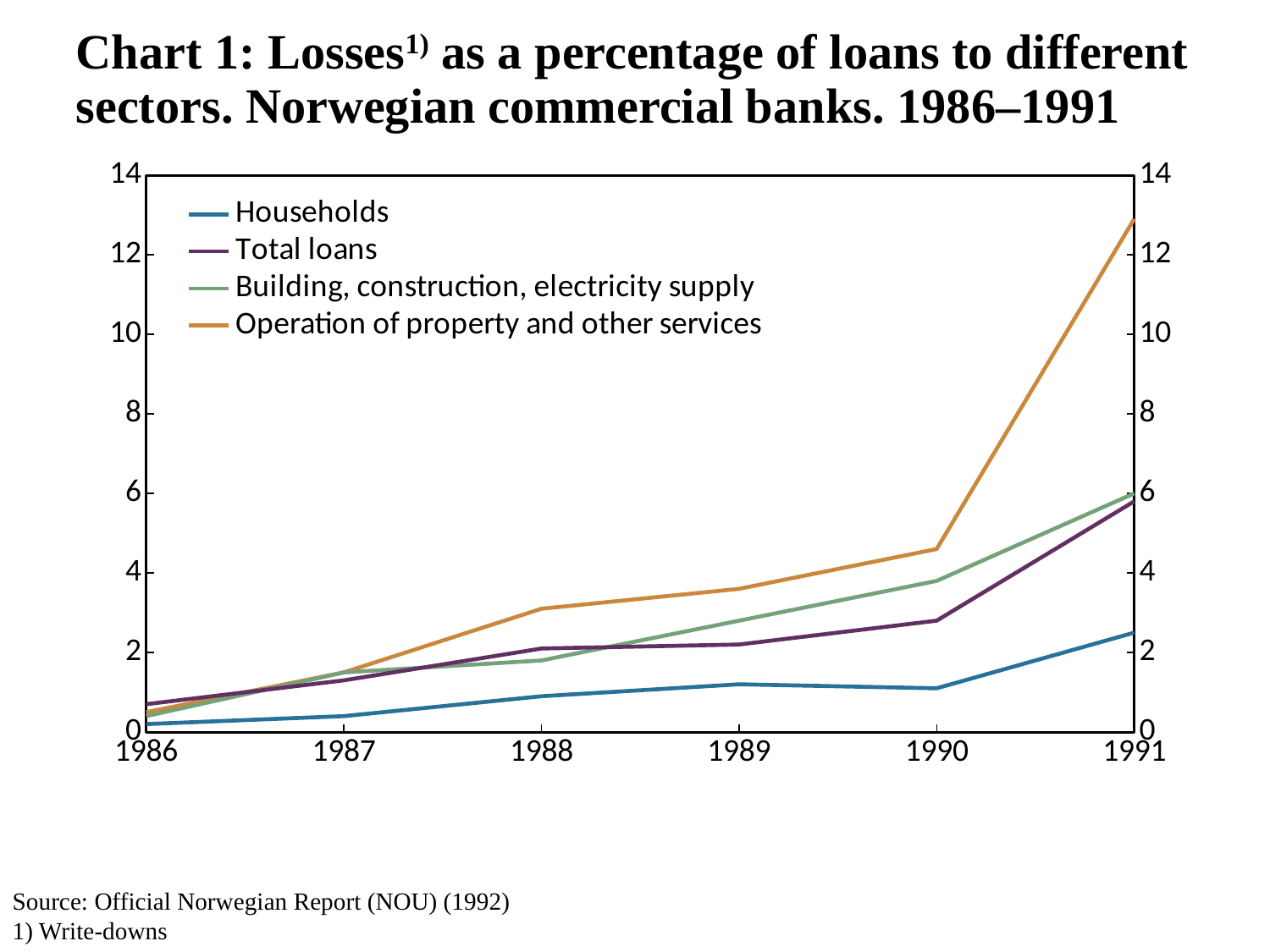
Is the value for Building, construction, electricity supply in 1991 greater or less than 4? greater Which series has the lowest value in 1991? Households Is the value for Households in 1991 greater or less than 2? greater Which series has the highest value in 1991? Operation of property and other services What kind of chart is shown on the slide? line chart How many years are plotted along the x axis? 6 What colour is the Households line in the legend? blue Does the Operation of property and other services series rise or fall from 1986 to 1991? rise In 1990, which is larger: Building, construction, electricity supply or Total loans? Building, construction, electricity supply Is the value for Total loans in 1990 greater or less than 4? less How many series does the legend list? 4